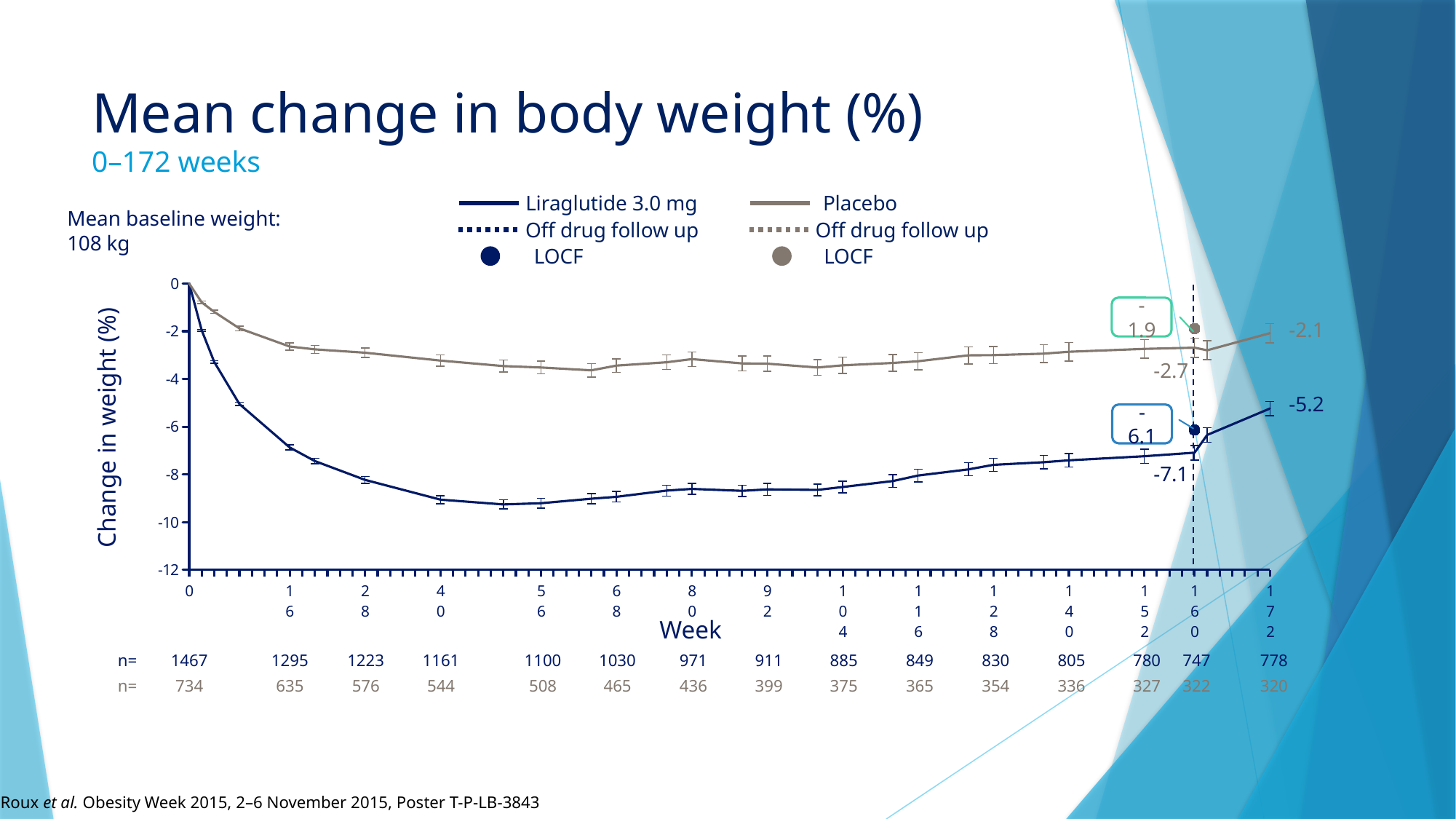
Does the Liraglutide 3.0 mg line rise or fall between week 56 and week 160? rise What is the LOCF value shown for Placebo? -1.9 What is the mean change in body weight for Placebo at week 172? -2.1 What is the mean change in body weight for Liraglutide 3.0 mg at week 160? -7.1 Is the value for Liraglutide 3.0 mg at week 56 greater or less than -8? less What is the difference between the Liraglutide 3.0 mg and Placebo values at week 172? 3.1 What mean baseline weight is stated on the slide? 108 kg What is the mean change in body weight for Liraglutide 3.0 mg at week 172? -5.2 What kind of chart is shown on the slide? Line chart What is the mean change in body weight for Placebo at week 160? -2.7 Which treatment group shows the greater weight loss at week 160? Liraglutide 3.0 mg What is the LOCF value shown for Liraglutide 3.0 mg? -6.1